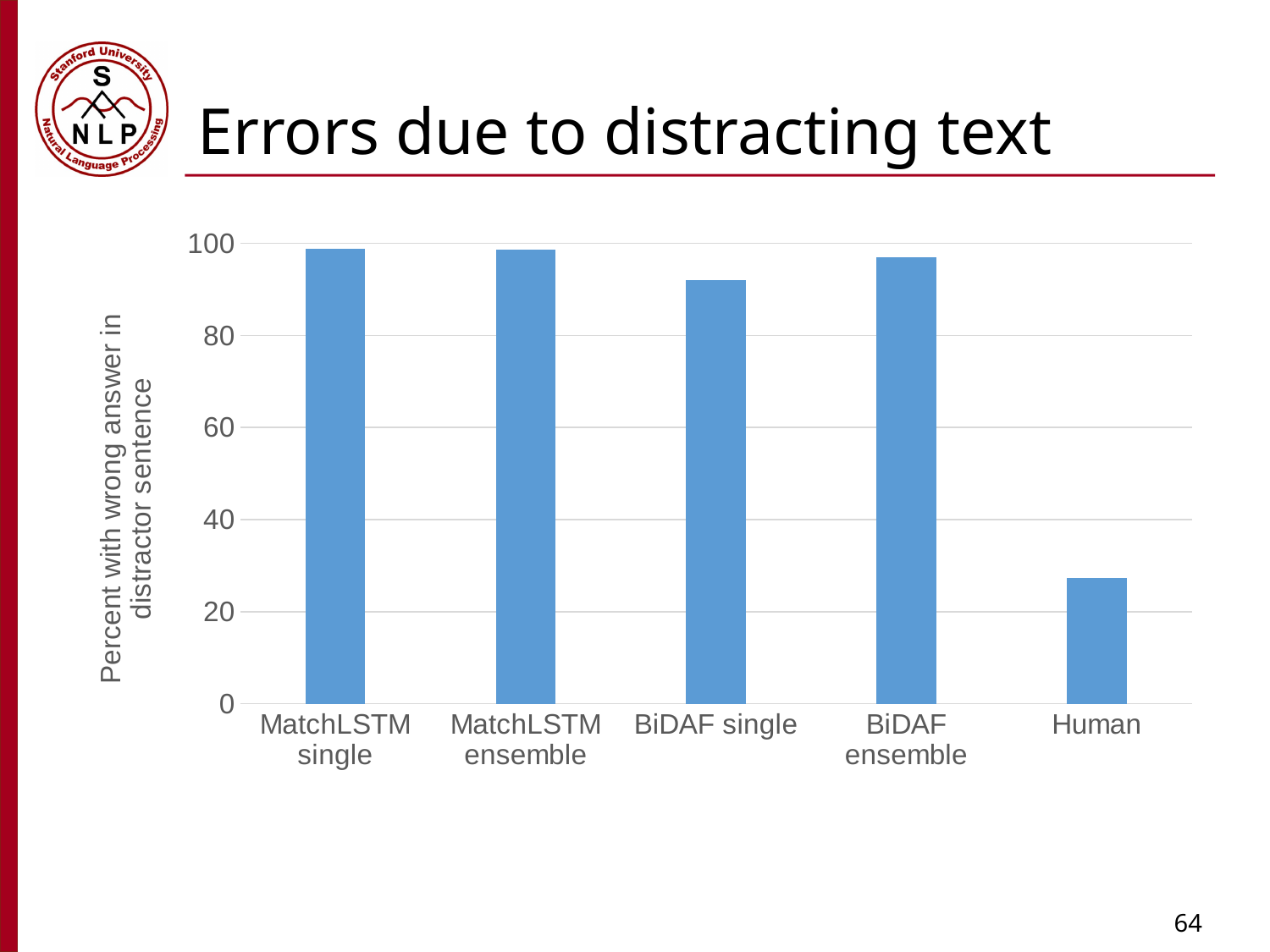
What is the title of the chart on the slide? Errors due to distracting text Which category has the lowest value in the chart? Human Is the value for MatchLSTM single greater or less than 80? greater Is the value for BiDAF single greater or less than 80? greater How many categories are shown on the x axis of the chart? 5 What is the label of the y axis of the chart? Percent with wrong answer in distractor sentence Which is larger, the value for Human or the value for BiDAF single? BiDAF single What kind of chart is shown on the slide? bar chart Is the value for BiDAF ensemble greater or less than 60? greater Which is larger, the value for BiDAF single or the value for BiDAF ensemble? BiDAF ensemble